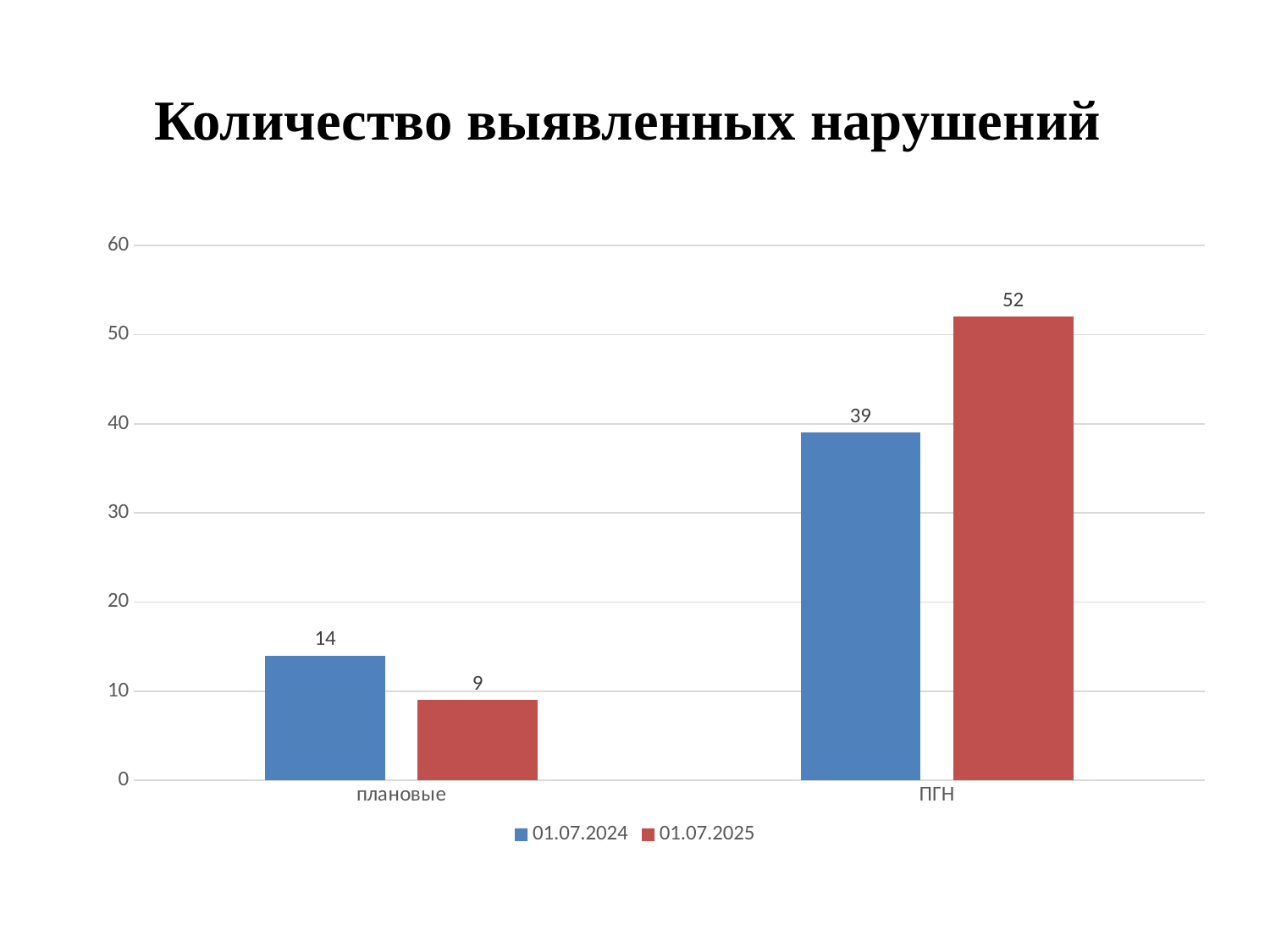
What is the value for ПГН in the 01.07.2025 series? 52 For ПГН, which series has the larger value, 01.07.2024 or 01.07.2025? 01.07.2025 What is the value for плановые in the 01.07.2025 series? 9 How many series does the legend list? 2 What is the difference between the 01.07.2025 and 01.07.2024 values for ПГН? 13 What is the difference between the 01.07.2024 and 01.07.2025 values for плановые? 5 Is the value for ПГН in the 01.07.2025 series greater or less than 50? greater Which category has the highest value in the 01.07.2024 series? ПГН What kind of chart is shown on the slide? bar chart How many categories are shown on the x axis? 2 Which category has the lowest value in the 01.07.2025 series? плановые What is the value for плановые in the 01.07.2024 series? 14